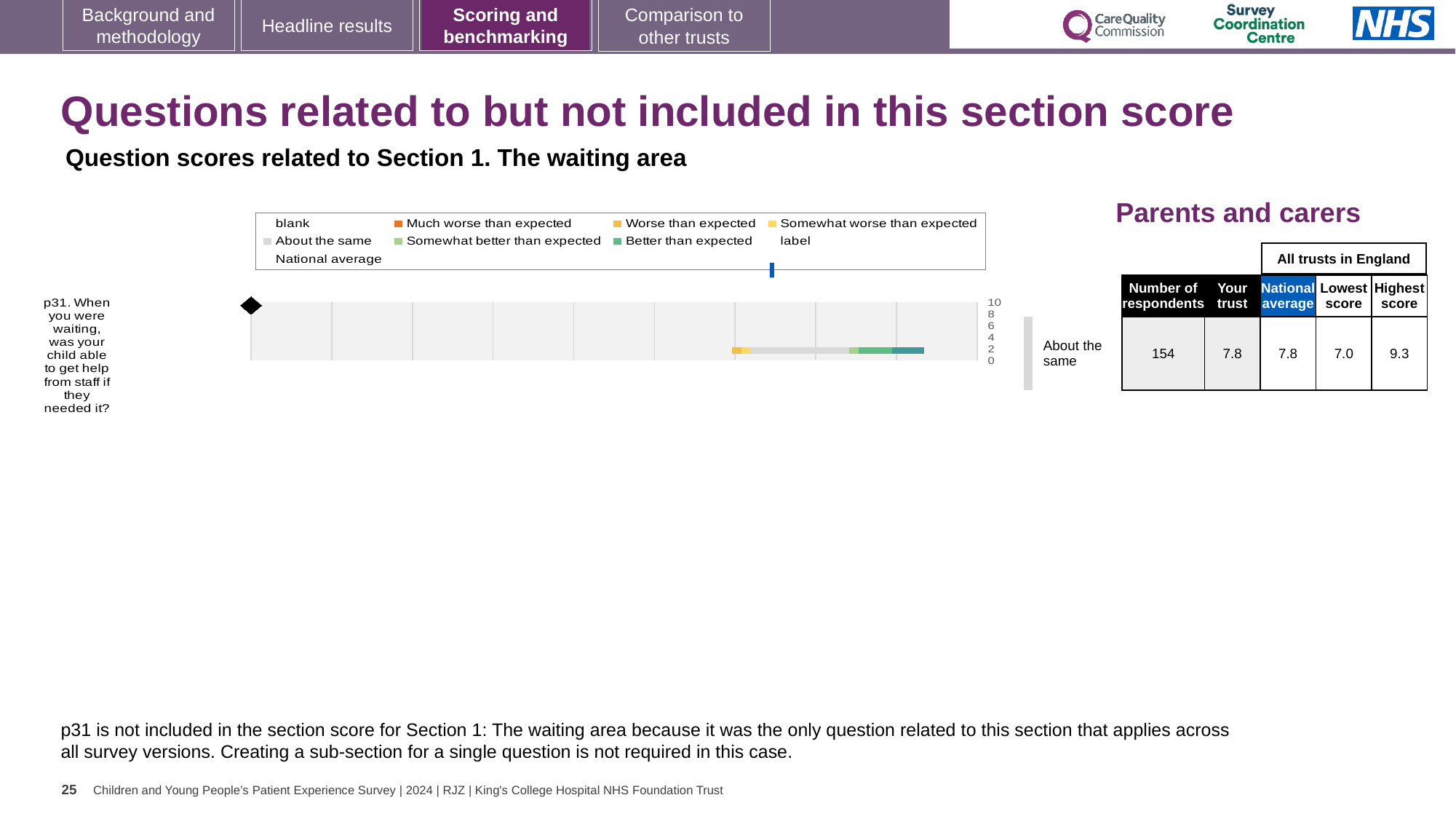
In the table beside the chart, what is the highest score across all trusts in England for p31? 9.3 What is the difference between the highest and lowest trust scores for p31? 2.3 In the table beside the chart, what is the national average score for p31? 7.8 How much higher is the trust's p31 score than the lowest score in England? 0.8 What benchmark category label is shown to the right of the p31 bar? About the same In the table beside the chart, how many respondents answered p31? 154 How many survey questions are plotted in the chart? 1 What kind of chart is used to show the p31 question score? bar chart In the table beside the chart, what is the lowest score across all trusts in England for p31? 7.0 In the table beside the chart, what is the 'Your trust' score for p31? 7.8 Is the highest score for p31 larger than the trust's own score? Yes, 9.3 is larger than 7.8 Which legend entry is shown in orange? Much worse than expected